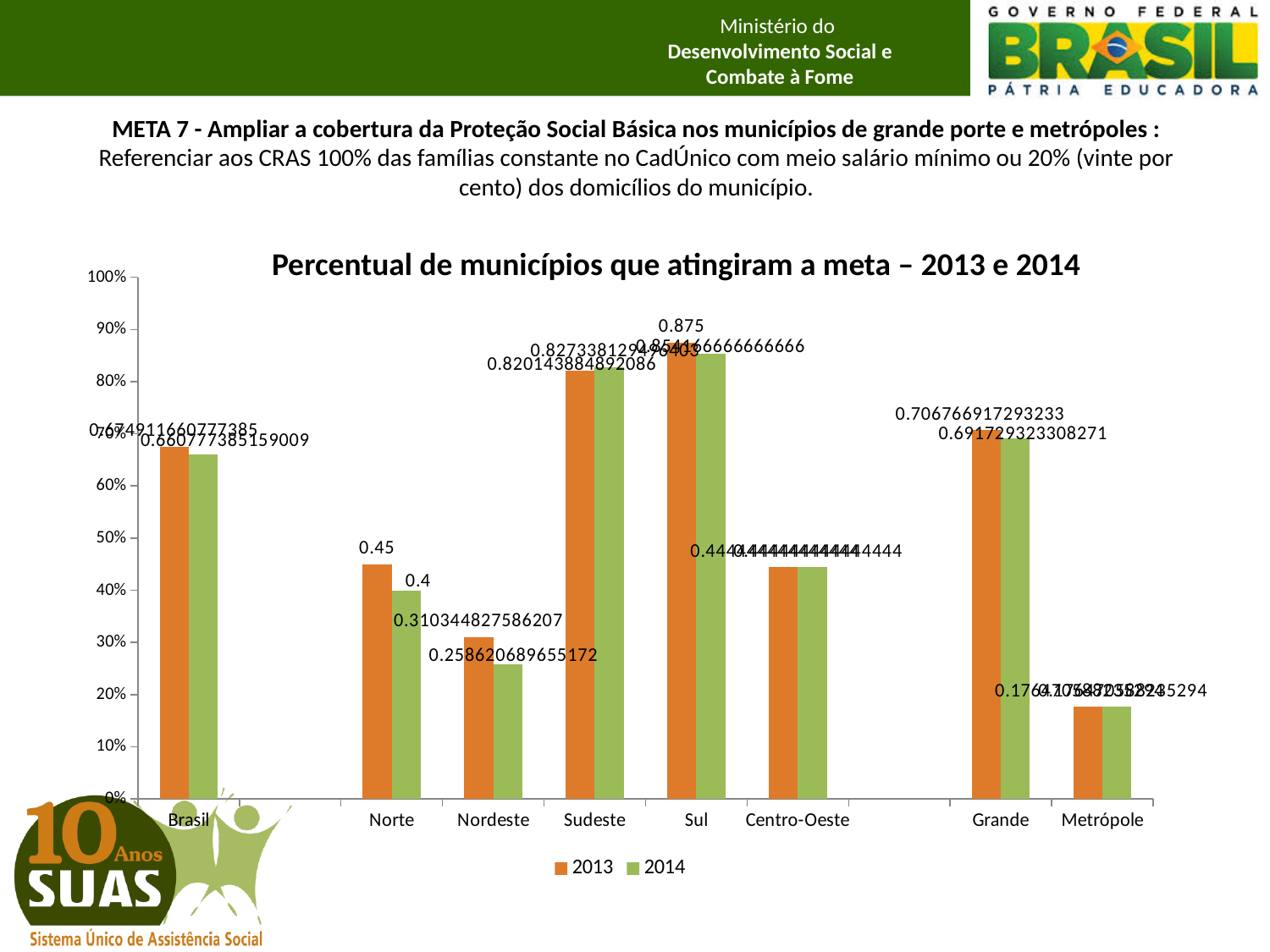
Which category has the highest value in 2013? Sul How many categories are shown on the x axis? 8 What is the difference between the 2013 and 2014 values for Norte? 0.05 What is the value for Grande in 2013? 0.706766917293233 Which category has the lowest value in 2014? Metrópole Is the 2013 value for Metrópole greater or less than 20%? less How many series does the legend list? 2 What type of chart is shown on the slide? bar chart What is the value for Sul in 2013? 0.875 What is the value for Norte in 2014? 0.4 What is the value for Norte in 2013? 0.45 What is the value for Nordeste in 2014? 0.258620689655172